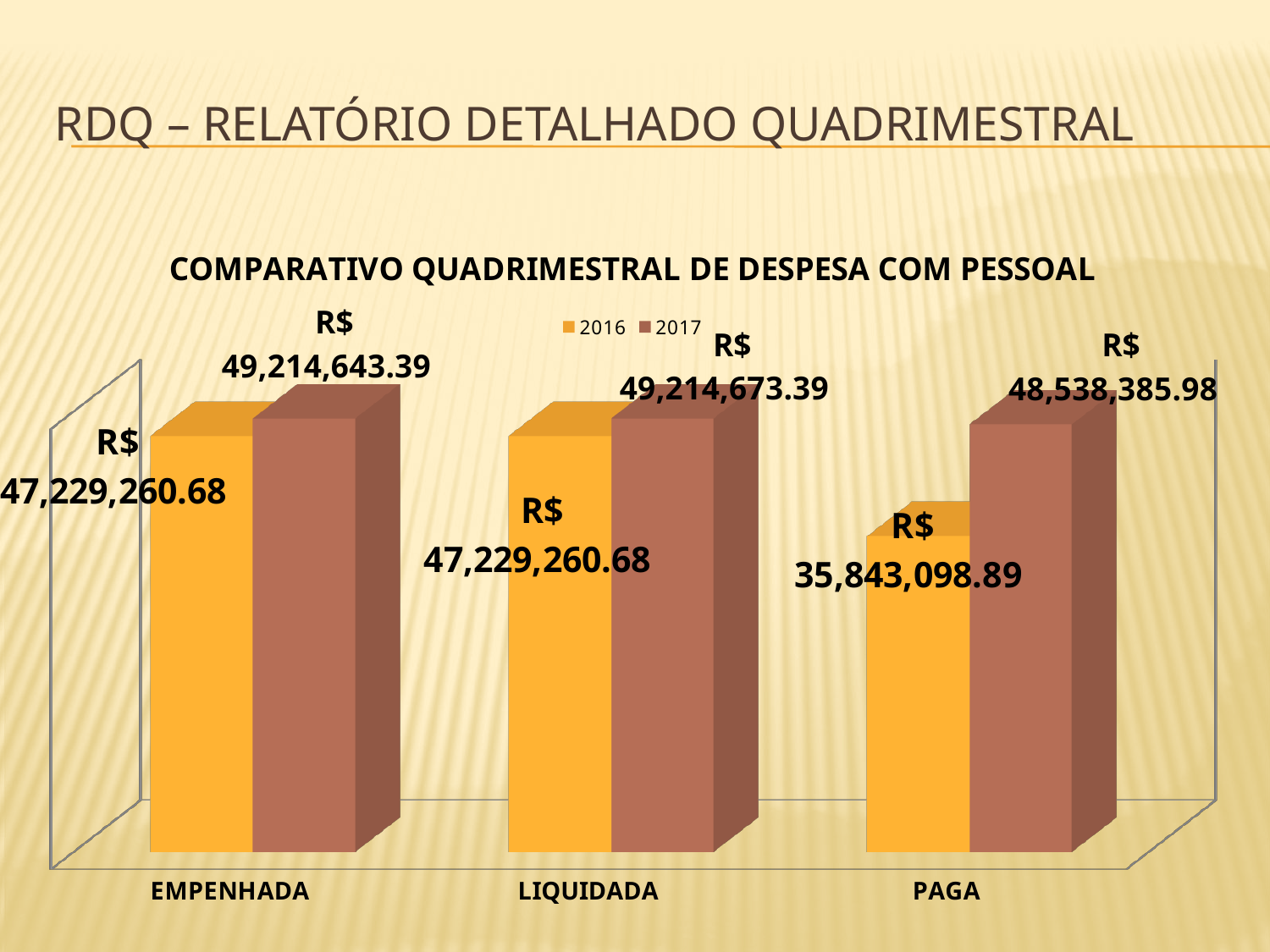
Which category has the lowest 2017 value? PAGA What is the 2017 value for LIQUIDADA? R$ 49,214,673.39 What is the 2016 value for PAGA? R$ 35,843,098.89 What is the difference between the 2017 and 2016 values for PAGA? R$ 12,695,287.09 What is the 2017 value for PAGA? R$ 48,538,385.98 How many series does the legend list? 2 Which category has the lowest 2016 value? PAGA For PAGA, which year has the larger value, 2016 or 2017? 2017 What is the difference between the 2017 and 2016 values for EMPENHADA? R$ 1,985,382.71 What is the 2016 value for EMPENHADA? R$ 47,229,260.68 What kind of chart is shown on the slide? Bar chart How many categories are shown on the x axis? 3